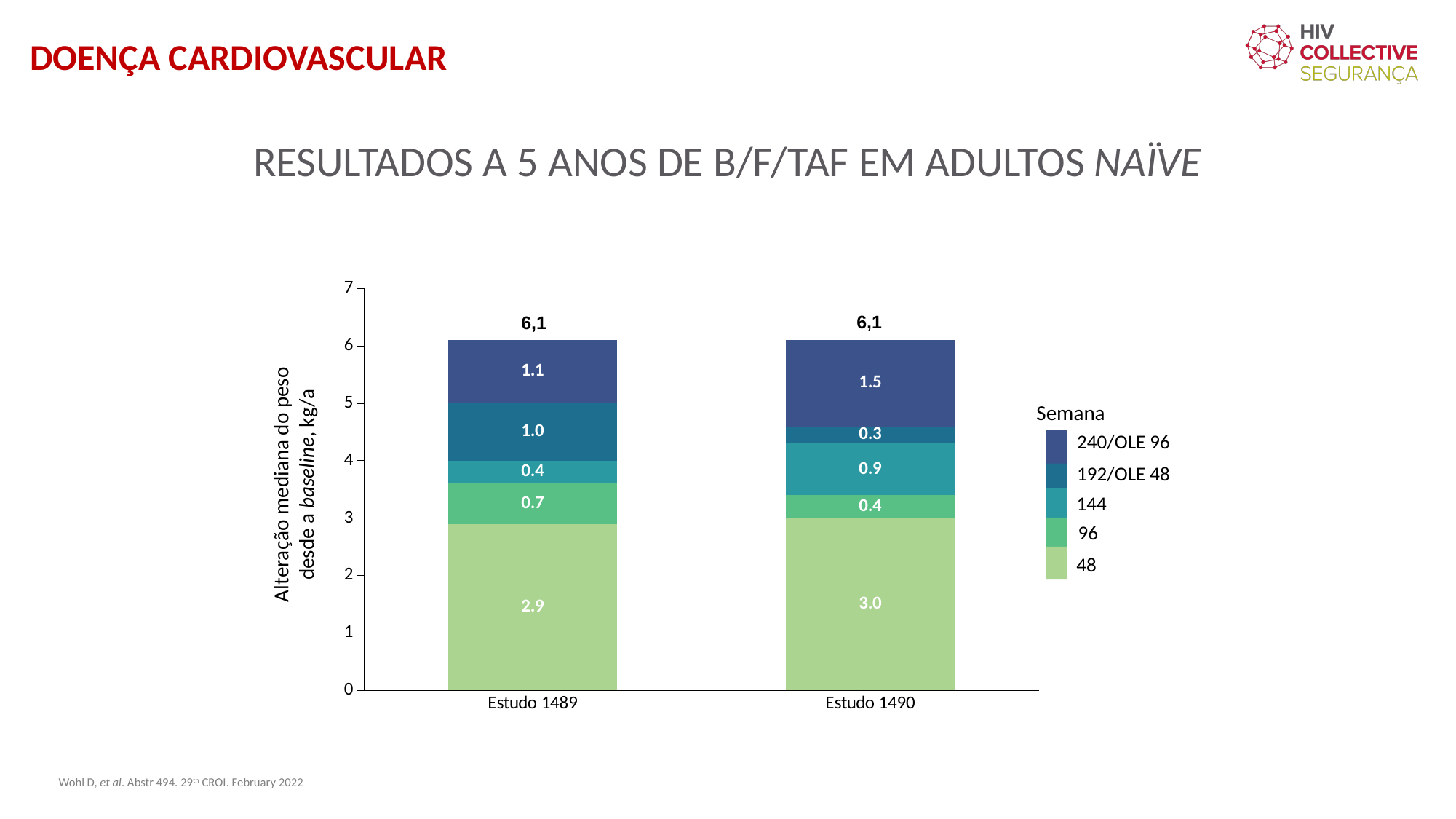
What is the total of the stacked bar for Estudo 1489? 6,1 Which is larger, the week 144 value for Estudo 1489 or for Estudo 1490? Estudo 1490 What is the value for week 48 in Estudo 1489? 2.9 What is the title of the legend? Semana How many series does the legend list? 5 How many categories are shown on the x axis? 2 Which week segment is the largest in the Estudo 1490 bar? 48 Which week segment is the smallest in the Estudo 1490 bar? 192/OLE 48 What kind of chart is shown on the slide? Stacked bar chart What is the value for week 192/OLE 48 in Estudo 1490? 0.3 What is the difference between the week 240/OLE 96 values for Estudo 1490 and Estudo 1489? 0.4 What is the value for week 240/OLE 96 in Estudo 1490? 1.5